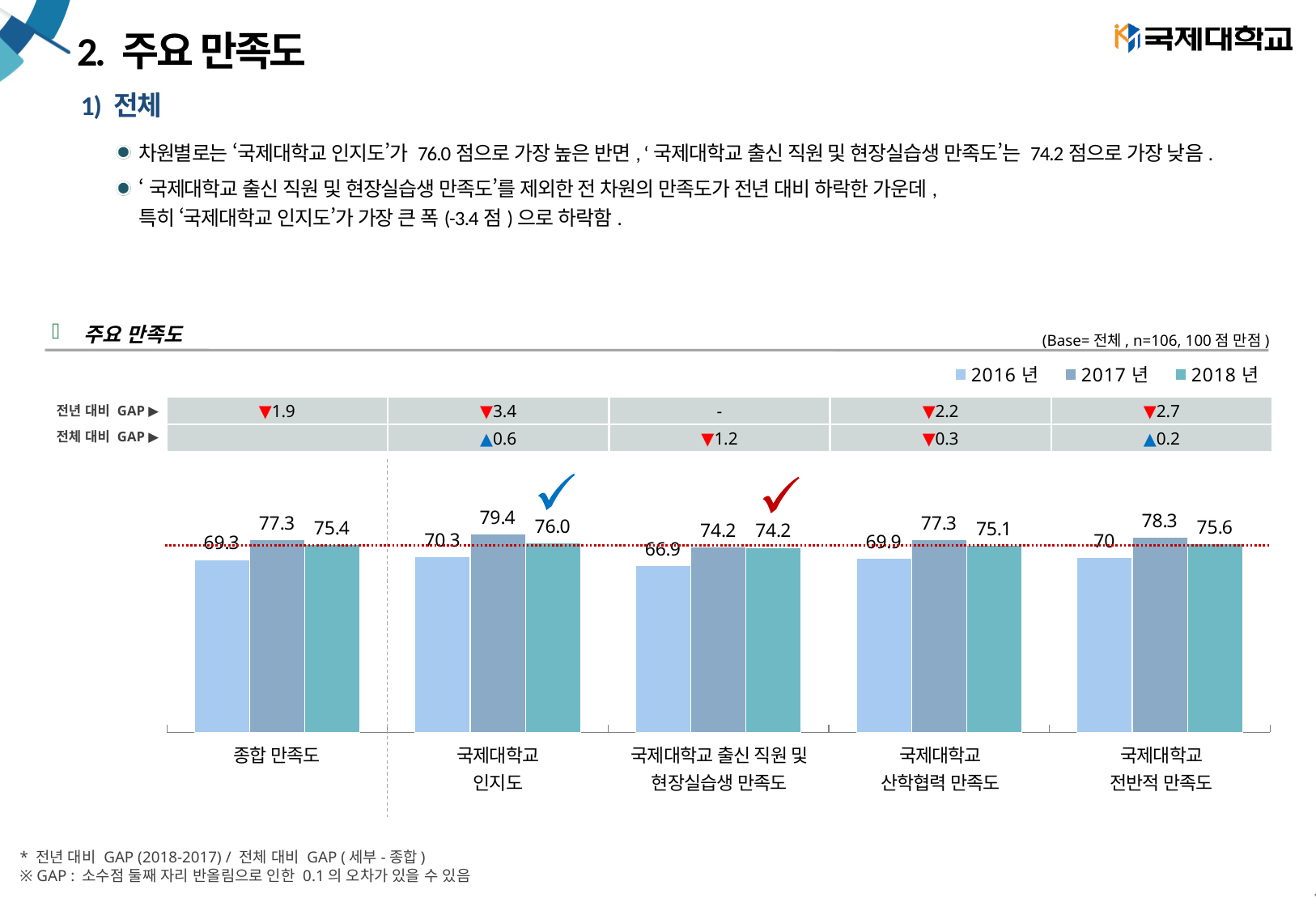
Which category has the lowest 2016년 value? 국제대학교 출신 직원 및 현장실습생 만족도 Which category has the highest 2018년 value? 국제대학교 인지도 How many series does the legend list? 3 What is the difference between the 2016년 and 2017년 values for 국제대학교 산학협력 만족도? 7.4 Which series is shown in the lightest blue colour in the legend? 2016년 What type of chart is shown on the slide? bar chart What is the 2017년 value for 국제대학교 전반적 만족도? 78.3 Which is larger for 종합 만족도: the 2017년 value or the 2018년 value? 2017년 How many categories are shown on the x axis of the chart? 5 What is the 2016년 value for 국제대학교 출신 직원 및 현장실습생 만족도? 66.9 What is the difference between the 2017년 and 2018년 values for 국제대학교 인지도? 3.4 What is the 2018년 value for 국제대학교 인지도? 76.0